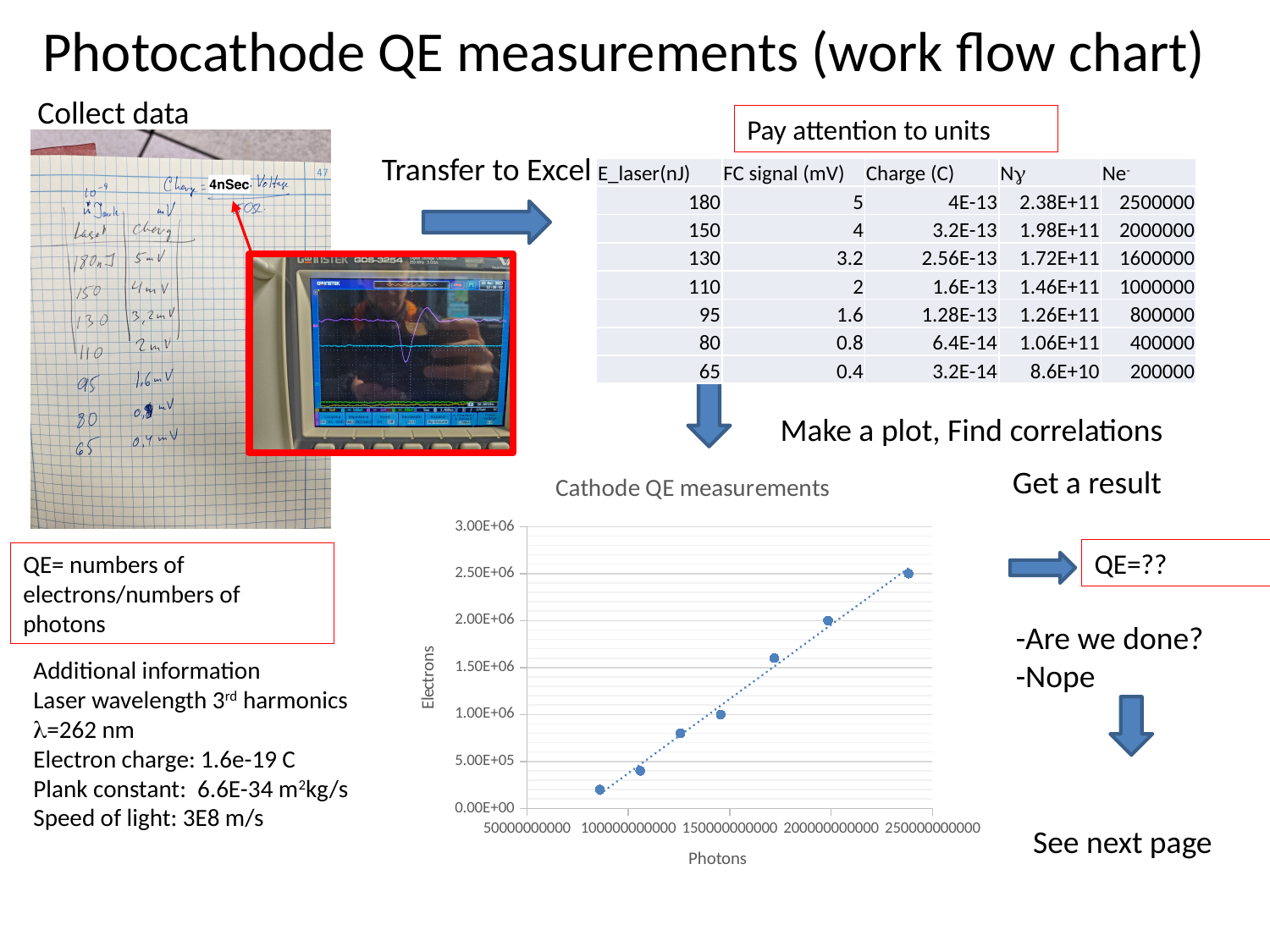
Is the Electrons value of the second-lowest plotted point greater or less than 5.00E+05? less Is the Electrons value of the lowest plotted point greater or less than 5.00E+05? less What is the title of the chart? Cathode QE measurements Is the Electrons value of the point with the third-highest Photons value greater or less than 1.50E+06? greater Do the Electrons values rise or fall as Photons increase along the x axis? rise How many data points are plotted in the chart? 7 What kind of chart is shown on the slide? scatter chart What is the Electrons value of the highest plotted point? 2.50E+06 What is the label of the x axis of the chart? Photons Which plotted point has the higher Electrons value, the one with the most Photons or the one with the fewest Photons? the one with the most Photons